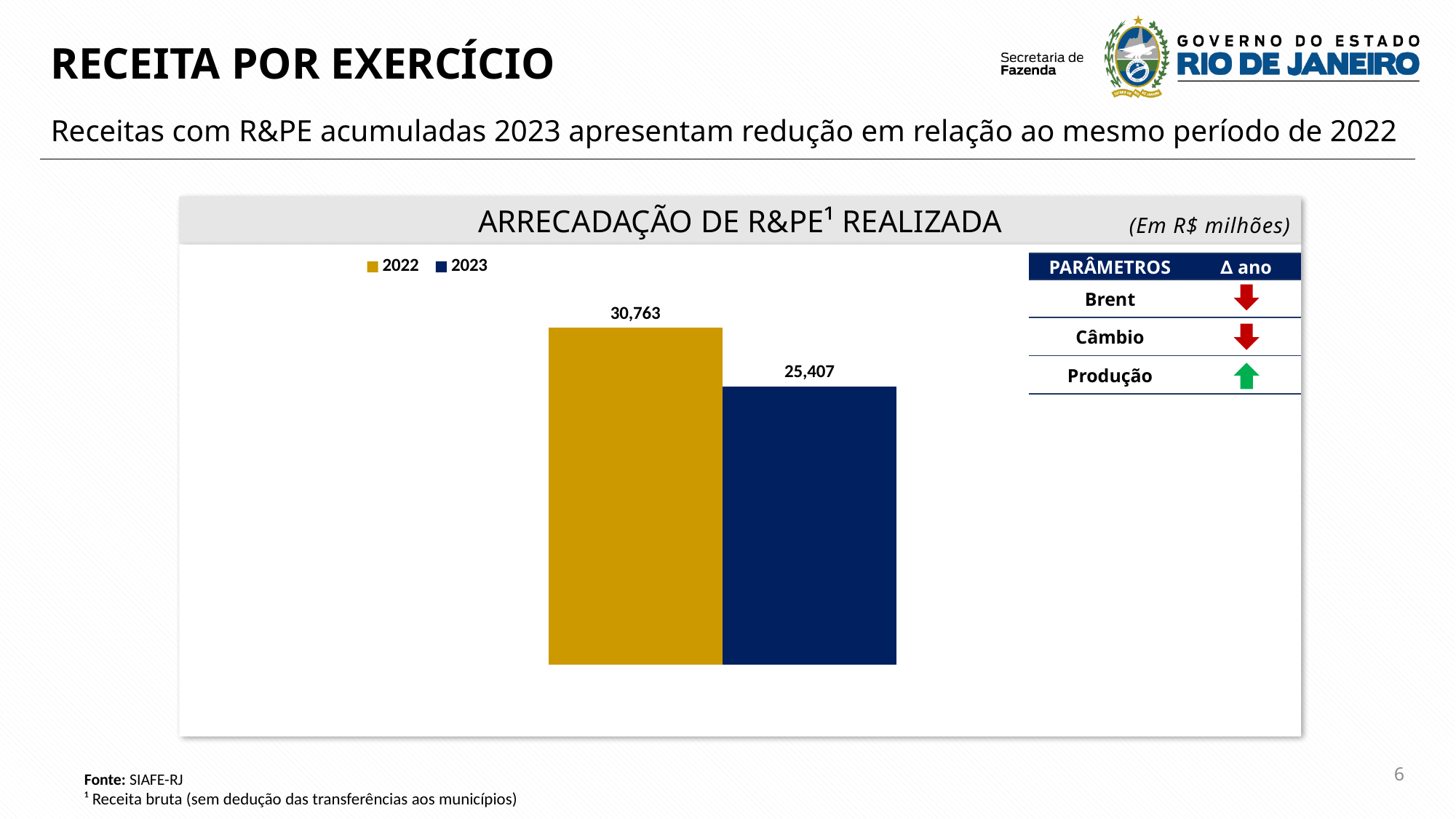
Which year has the lower value in the chart? 2023 What is the value shown for 2022 in the chart? 30,763 Which year has the higher value in the chart? 2022 How many series does the chart legend list? 2 How many bars are plotted in the chart? 2 What kind of chart is shown on the slide? bar chart In what unit are the chart values expressed? R$ milhões Do the values rise or fall from 2022 to 2023? fall What is the title of the chart? ARRECADAÇÃO DE R&PE¹ REALIZADA What is the value shown for 2023 in the chart? 25,407 What is the difference between the 2022 and 2023 values in the chart? 5,356 Is the value for 2023 larger or smaller than the value for 2022? smaller